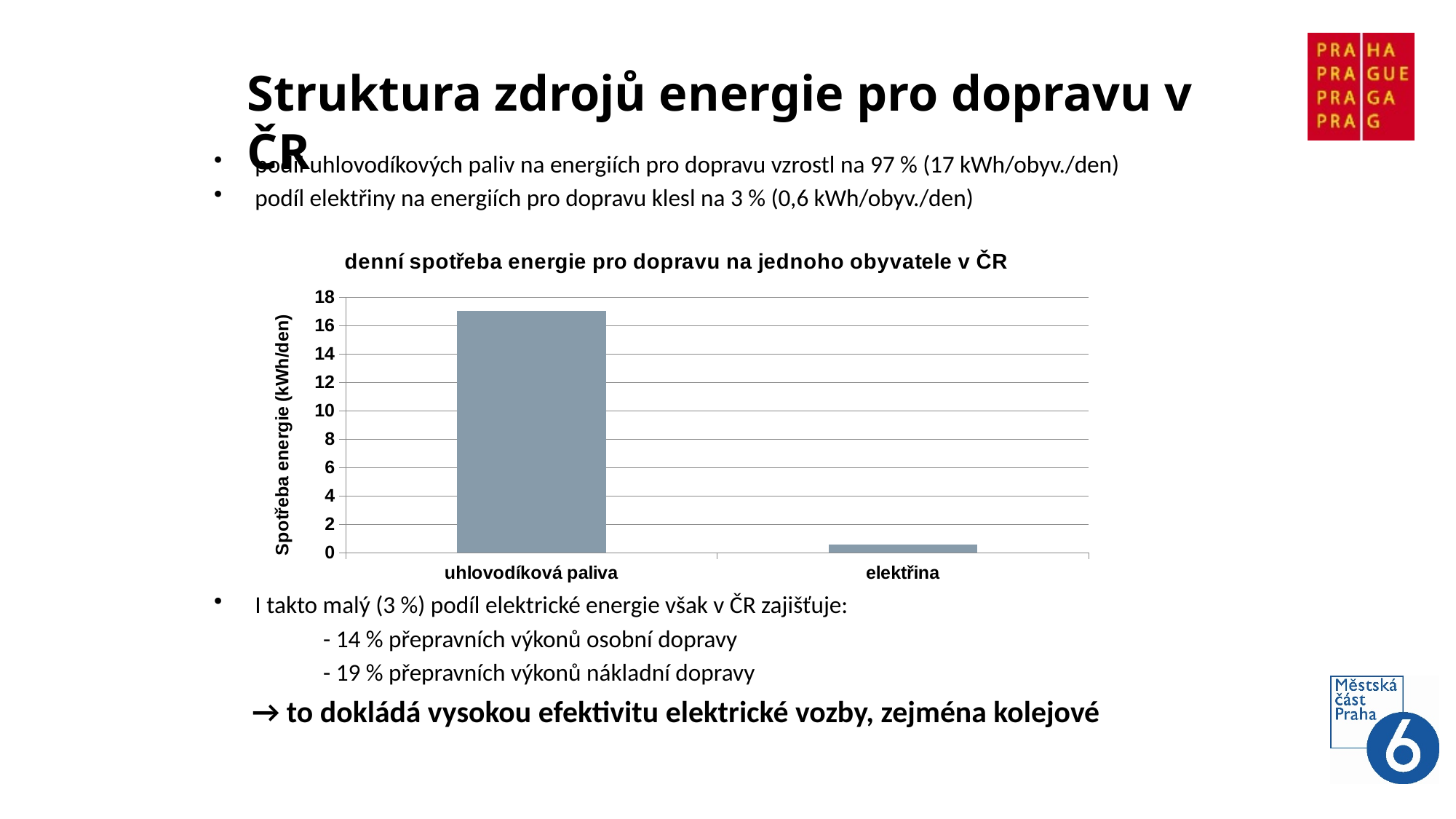
What kind of chart is shown on the slide? bar chart Do the bar values rise or fall from left to right along the x axis? fall How many categories are plotted on the x axis of the chart? 2 Is the value for elektřina greater or less than 2? less What is the title of the chart? denní spotřeba energie pro dopravu na jednoho obyvatele v ČR Is the value for uhlovodíková paliva greater or less than 10? greater Is the value for uhlovodíková paliva greater or less than 16? greater Which is larger in the chart, the value for uhlovodíková paliva or the value for elektřina? uhlovodíková paliva What is the label of the vertical axis of the chart? Spotřeba energie (kWh/den) Which category has the highest daily energy consumption in the chart? uhlovodíková paliva Which category has the lowest daily energy consumption in the chart? elektřina